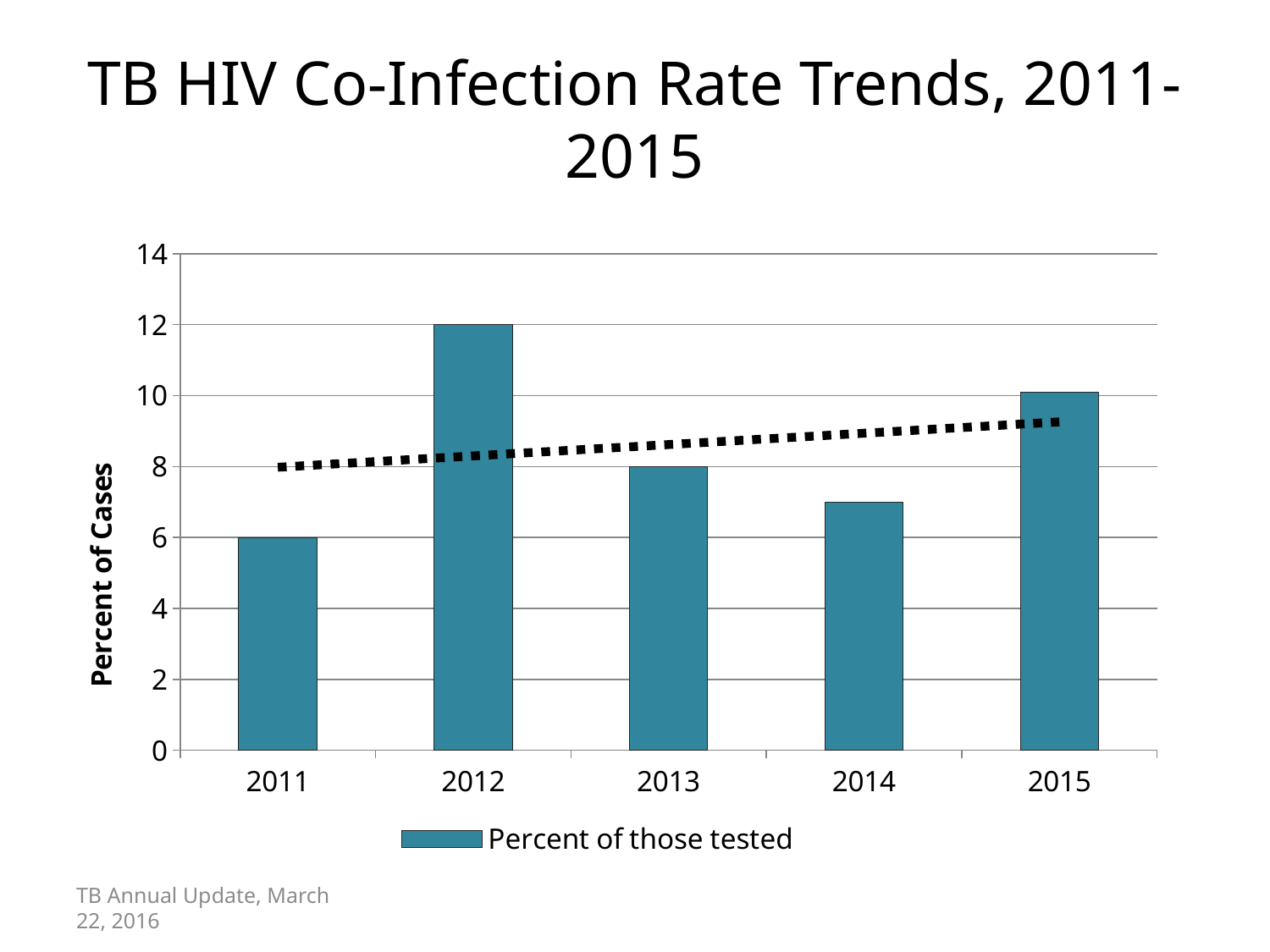
How many series does the legend list? 1 How many years are shown on the x axis? 5 What is the value for 2013? 8 Which year has the larger value, 2013 or 2014? 2013 What is the difference between the values for 2012 and 2011? 6 What kind of chart is this? bar chart Which year has the lowest percent of those tested? 2011 Is the value for 2015 greater or less than 8? greater Which year has the highest percent of those tested? 2012 What is the value for 2011? 6 What is the value for 2012? 12